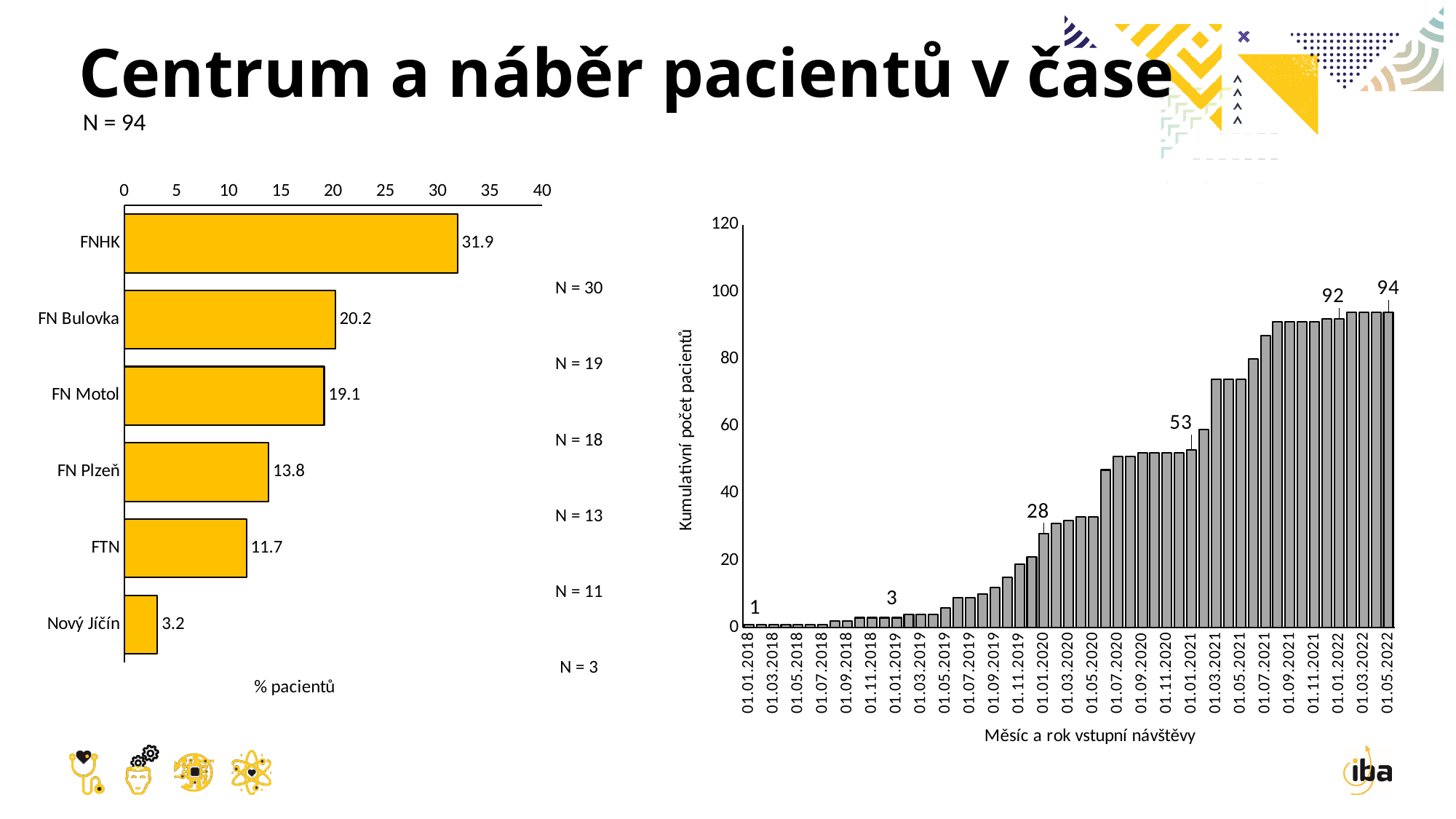
In the right chart (Kumulativní počet pacientů), is the value for 01.03.2021 greater or less than 60? greater How many centres are shown in the left chart (% pacientů)? 6 In the left chart (% pacientů), which centre has the lowest percentage? Nový Jíčín In the right chart (Kumulativní počet pacientů), what is the labelled value at 01.01.2020? 28 In the right chart (Kumulativní počet pacientů), do the values rise or fall along the x axis? Rise In the right chart (Kumulativní počet pacientů), what is the labelled value at 01.01.2021? 53 In the left chart (% pacientů), which has the larger value, FTN or FN Plzeň? FN Plzeň In the left chart (% pacientů), what is the difference between the values for FN Bulovka and FN Motol? 1.1 In the left chart (% pacientů), what is the value for FN Plzeň? 13.8 In the left chart (% pacientů), which centre has the highest percentage? FNHK What kind of chart is the left chart (% pacientů)? Bar chart In the left chart (% pacientů), what is the value for FNHK? 31.9